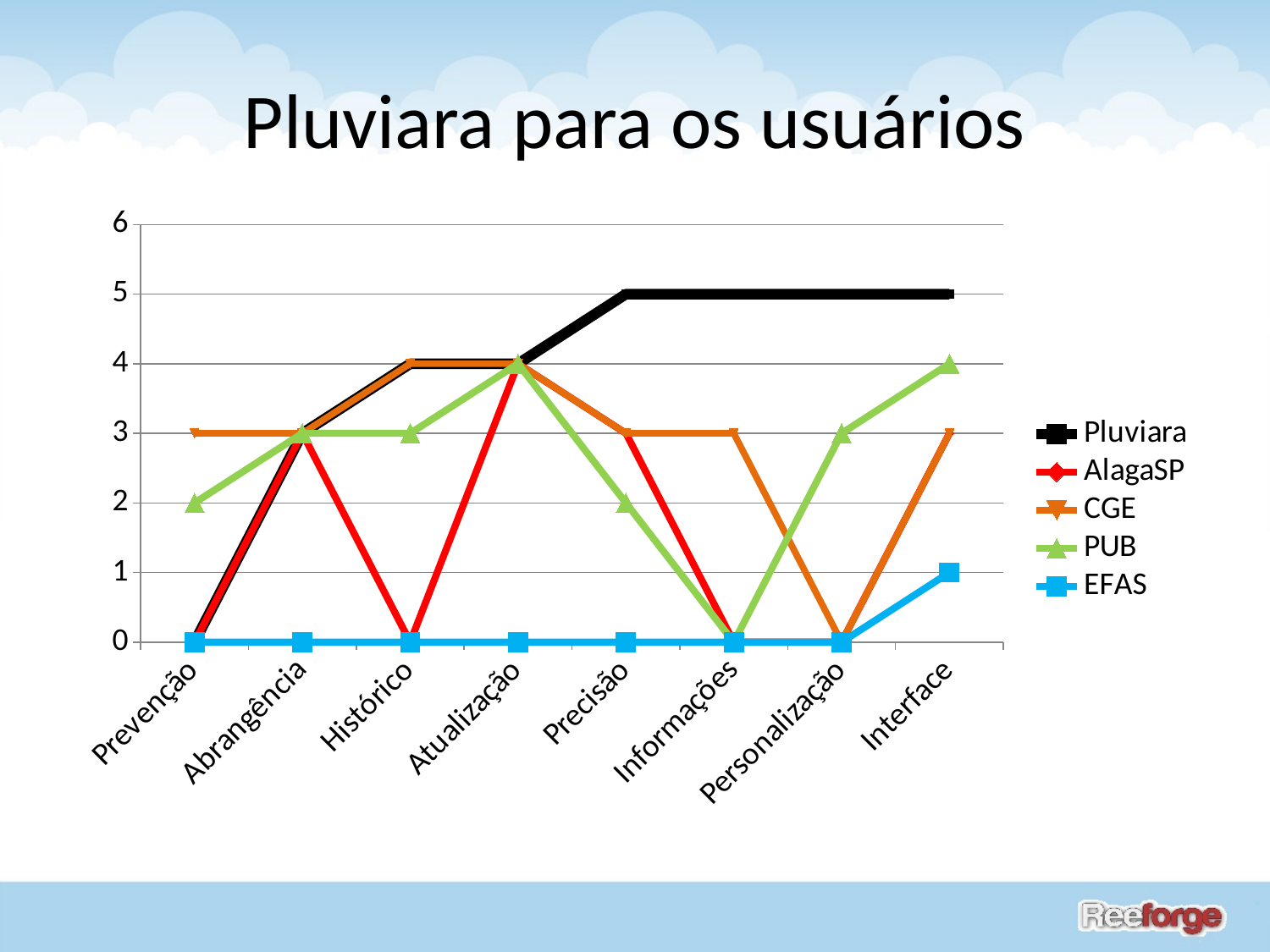
What is the value for PUB at Interface? 4 What kind of chart is shown on the slide? line chart How many categories are shown on the x axis? 8 Which is larger at Histórico, the value for CGE or the value for AlagaSP? CGE What is the value for CGE at Personalização? 0 Does the Pluviara series rise or fall from Prevenção to Precisão? rise What is the value for Pluviara at Precisão? 5 Which series has the highest value at Interface? Pluviara What is the difference between Pluviara and PUB at Precisão? 3 How many series does the legend list? 5 What is the value for EFAS at Interface? 1 Which series has the lowest value at Prevenção? Pluviara, AlagaSP and EFAS (all 0)